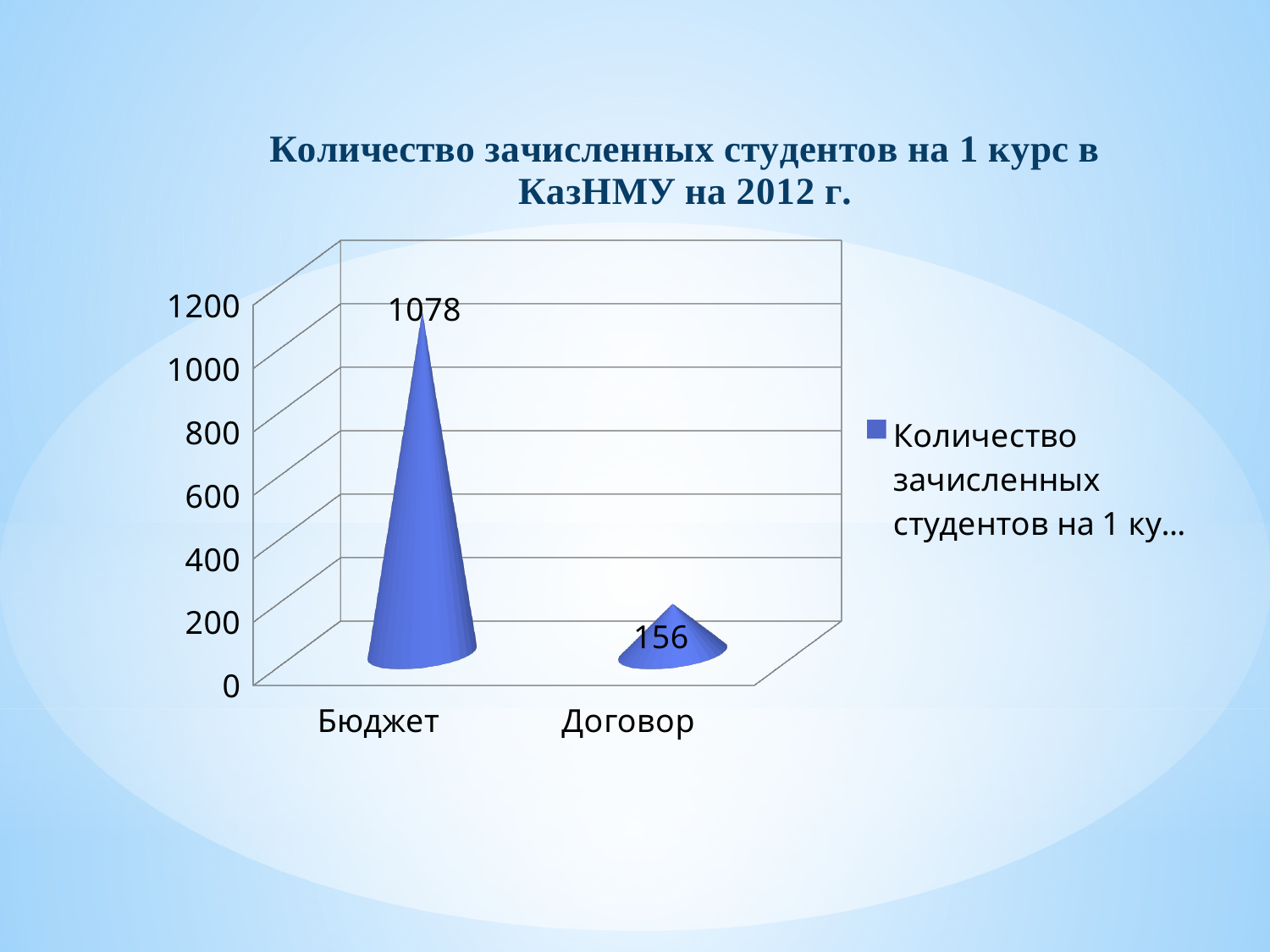
What is the value for Договор? 156 What is the difference between the values for Бюджет and Договор? 922 Which category has the lowest value? Договор What kind of chart is shown on the slide? bar chart What is the title of the chart? Количество зачисленных студентов на 1 курс в КазНМУ на 2012 г. Is the value for Бюджет greater or less than 1000? greater How many categories are shown on the x axis? 2 How many series does the legend list? 1 Which is larger, the value for Бюджет or the value for Договор? Бюджет Which category has the highest value? Бюджет What is the value for Бюджет? 1078 Is the value for Договор greater or less than 200? less